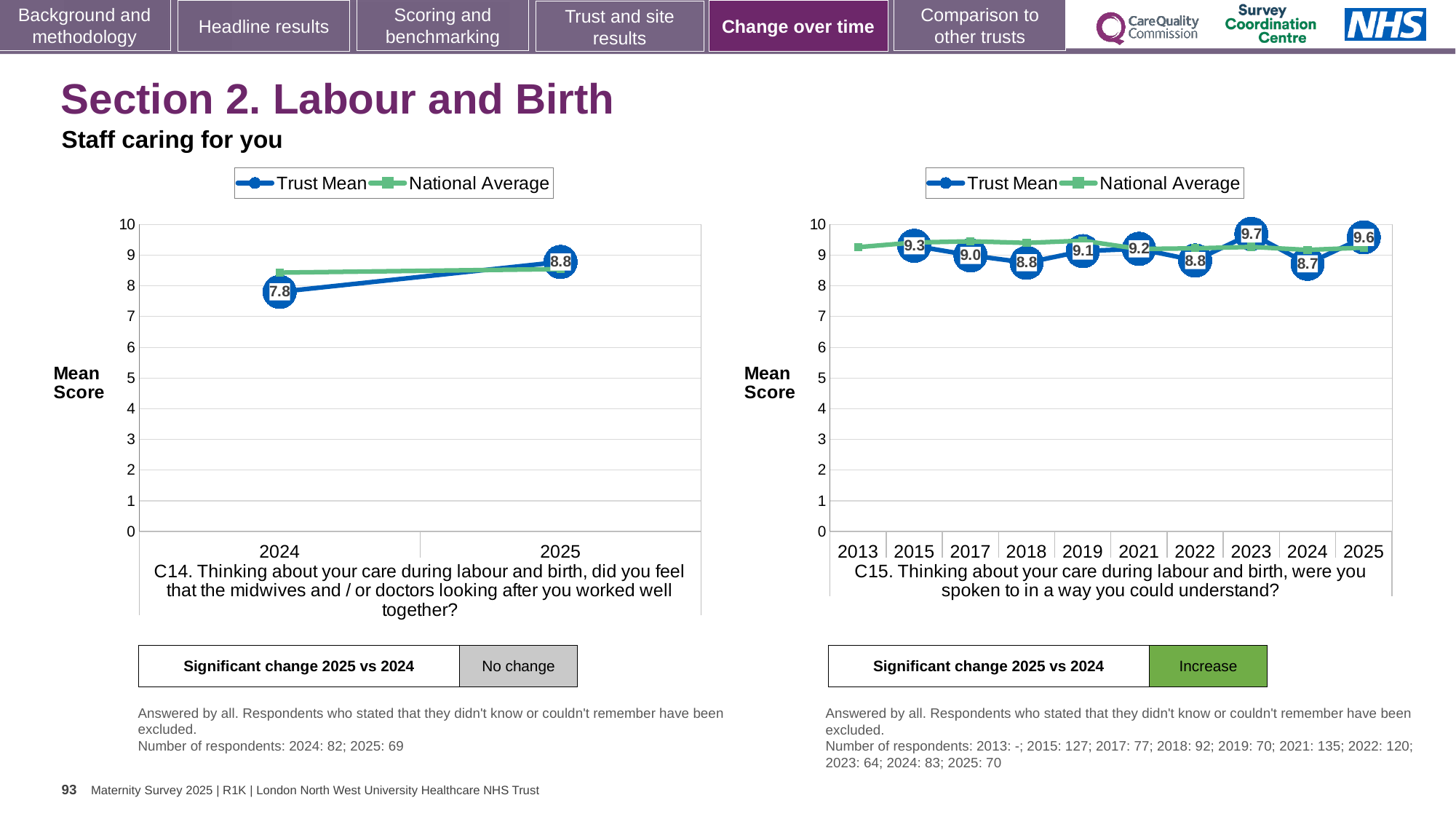
In the right chart (C15), which year has the highest Trust Mean value? 2023 In the right chart (C15), which year has the lowest Trust Mean value? 2024 In the right chart (C15), what is the difference between the Trust Mean values for 2025 and 2024? 0.9 In the left chart (C14), what is the Trust Mean value for 2025? 8.8 In the left chart (C14), what is the difference between the Trust Mean values for 2025 and 2024? 1.0 In the right chart (C15), how many years are shown on the x axis? 10 In the left chart (C14), does the Trust Mean rise or fall from 2024 to 2025? rise In the right chart (C15), what is the Trust Mean value for 2024? 8.7 In the right chart (C15), what is the Trust Mean value for 2023? 9.7 What type of chart is used on the left for question C14? line chart In the left chart (C14), what is the Trust Mean value for 2024? 7.8 In the left chart (C14), is the National Average value for 2024 greater or less than 8? greater